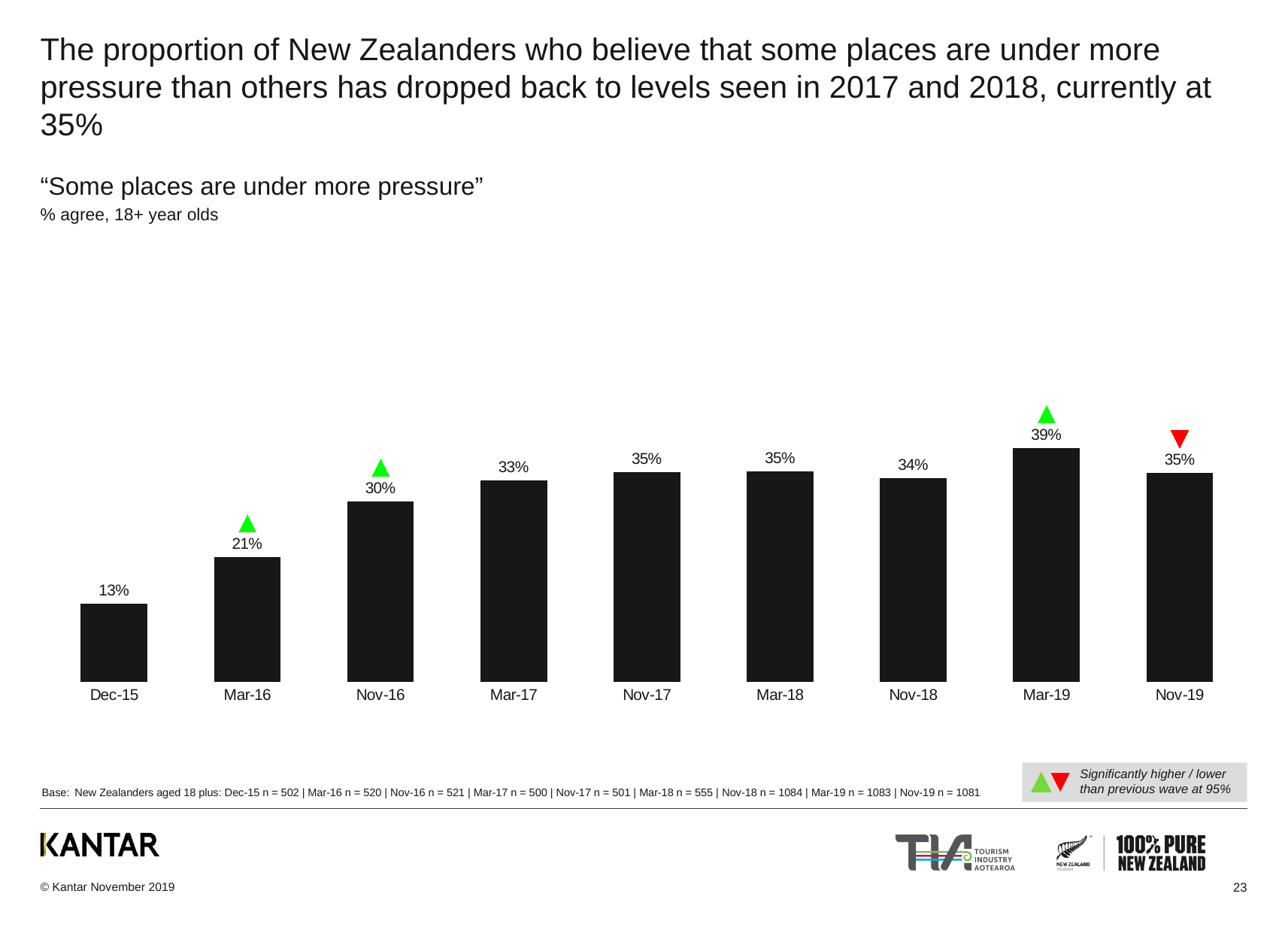
Which is larger, the value for Mar-17 or the value for Nov-16? Mar-17 Which period has the highest value? Mar-19 What is the value for Nov-16? 30% What kind of chart is shown on the slide? Bar chart What is the value for Dec-15? 13% What is the value for Nov-19? 35% What is the difference between the values for Mar-16 and Dec-15? 8% How many periods are shown on the x axis? 9 Do the values rise or fall from Dec-15 to Mar-17? Rise What is the value for Mar-19? 39% What is the difference between the values for Mar-19 and Nov-19? 4% Which period has the lowest value? Dec-15